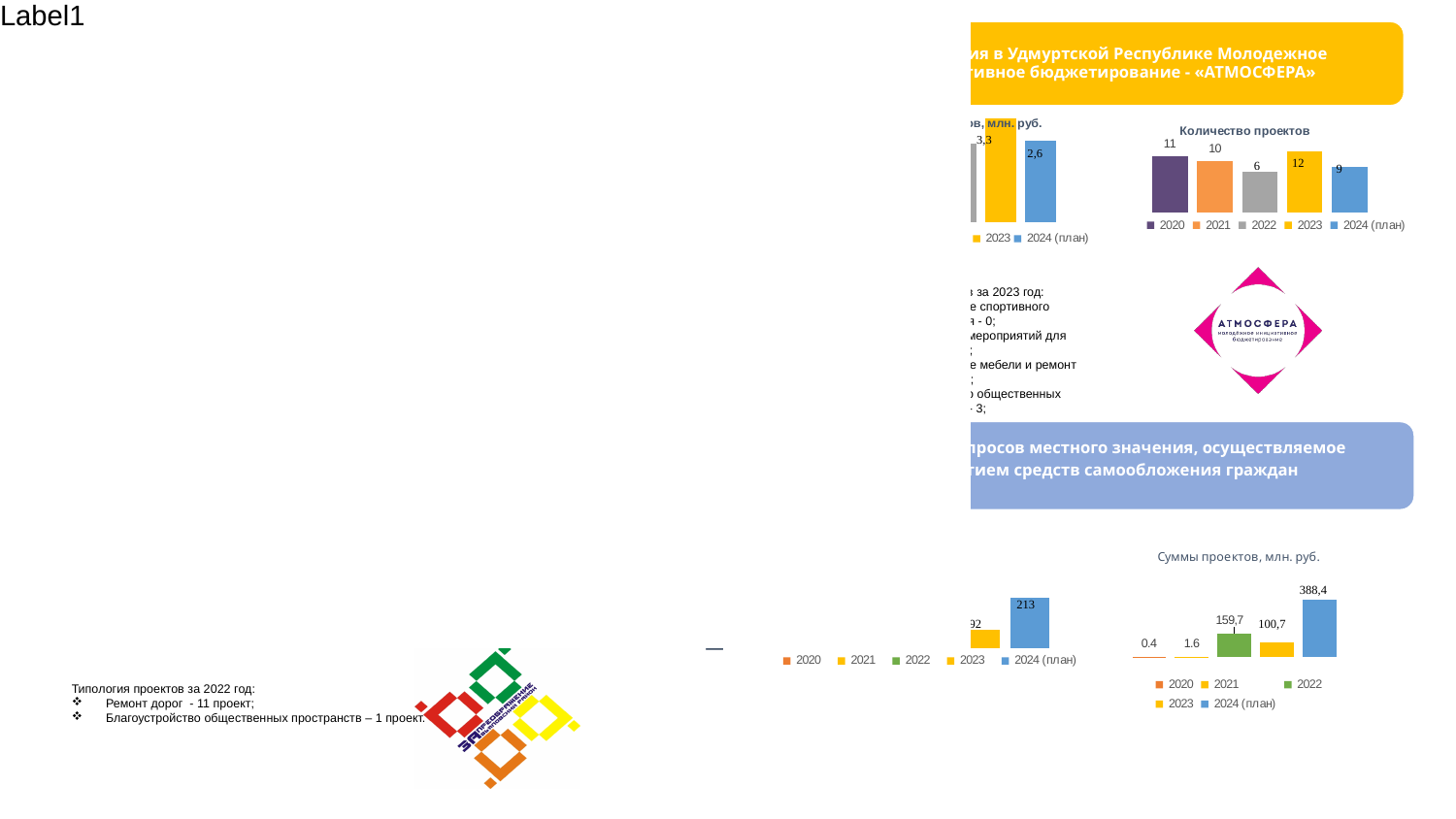
In the chart at the top of the slide whose legend lists only 2023 and 2024 (план), what is the value for 2024 (план)? 2,6 What kind of chart is the chart titled "Количество проектов"? bar chart In the chart titled "Суммы проектов, млн. руб.", which year has the lowest value? 2020 In the chart titled "Суммы проектов, млн. руб.", which is larger, the value for 2022 or the value for 2023? 2022 In the chart titled "Количество проектов", which year has the lowest value? 2022 In the chart titled "Суммы проектов, млн. руб.", what is the value for 2022? 159,7 In the chart titled "Количество проектов", what is the difference between the values for 2020 and 2024 (план)? 2 In the chart titled "Количество проектов", what is the value for 2023? 12 In the chart titled "Количество проектов", what is the value for 2022? 6 In the chart titled "Количество проектов", how many series does the legend list? 5 In the chart titled "Количество проектов", which year has the highest value? 2023 In the chart titled "Суммы проектов, млн. руб.", what is the value for 2024 (план)? 388,4